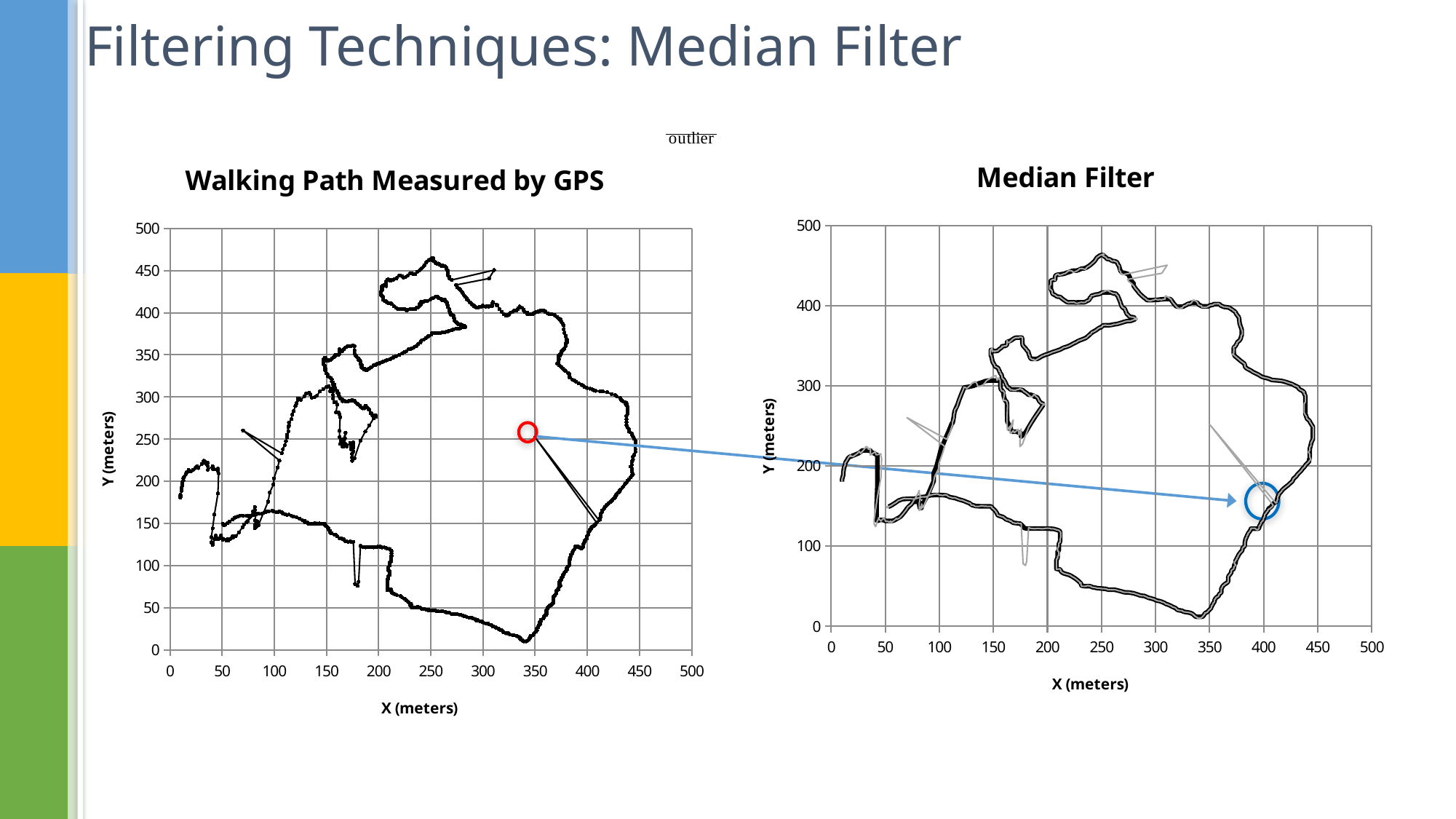
What kind of chart is the 'Walking Path Measured by GPS' chart? scatter chart What kind of chart is the 'Median Filter' chart? scatter chart In the 'Median Filter' chart, is the lowest Y value reached by the path (near X = 340) greater or less than 50? less In the 'Walking Path Measured by GPS' chart, is the highest Y value reached by the path (near X = 250) greater or less than 400? greater In the 'Median Filter' chart, is the largest X value reached by the path greater or less than 400? greater What is the title of the chart on the left of the slide? Walking Path Measured by GPS What is the label of the vertical axis on the 'Median Filter' chart? Y (meters)